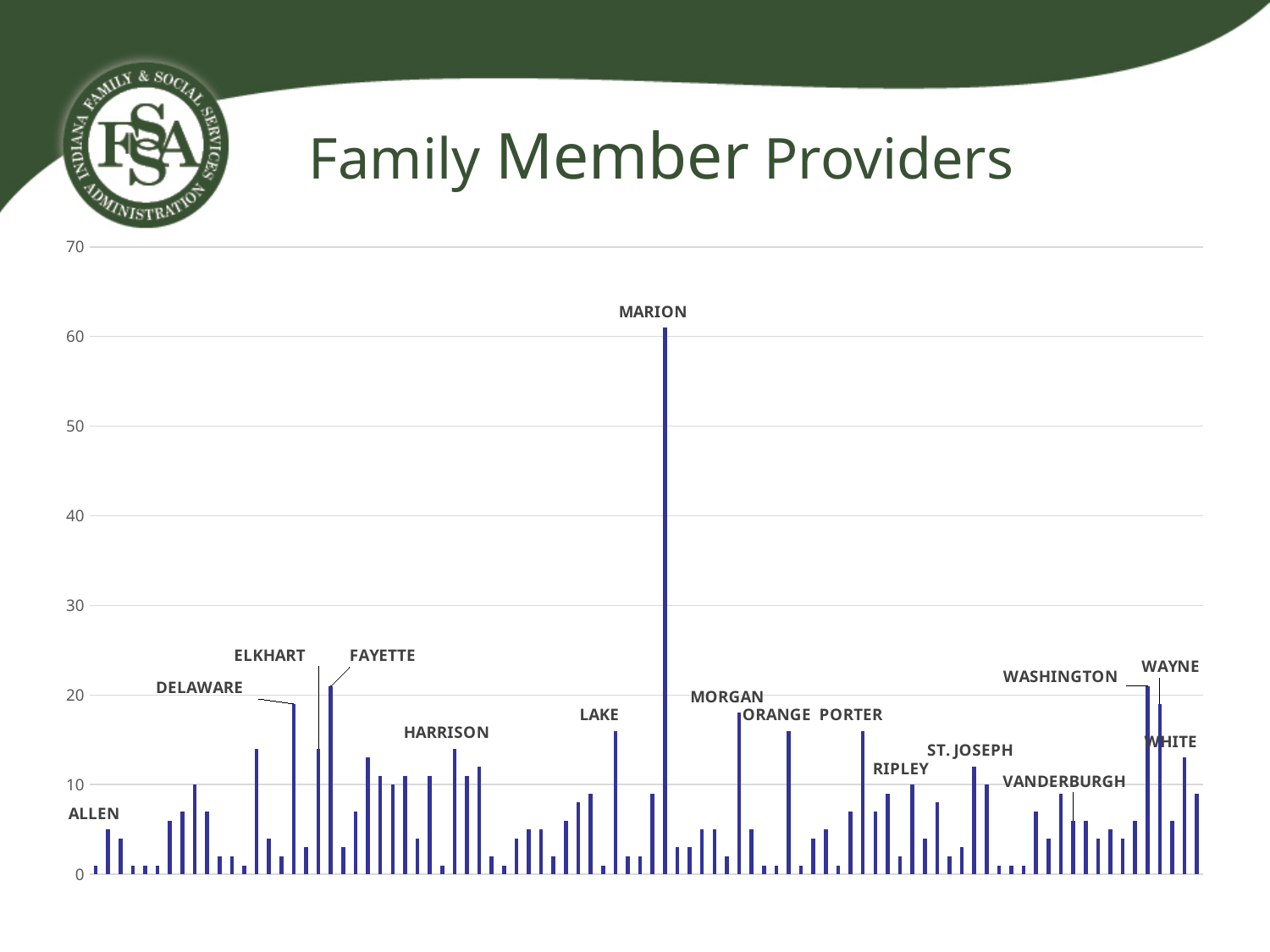
What kind of chart is shown on the slide? bar chart Is the value for HARRISON greater or less than 10? greater Which county has the highest number of family member providers? MARION What is the title of the chart? Family Member Providers What is the highest value shown on the vertical axis? 70 Is the value for MORGAN greater or less than 20? less Is the value for LAKE greater or less than 10? greater Which has more family member providers, ALLEN or HARRISON? HARRISON Which has more family member providers, MARION or LAKE? MARION